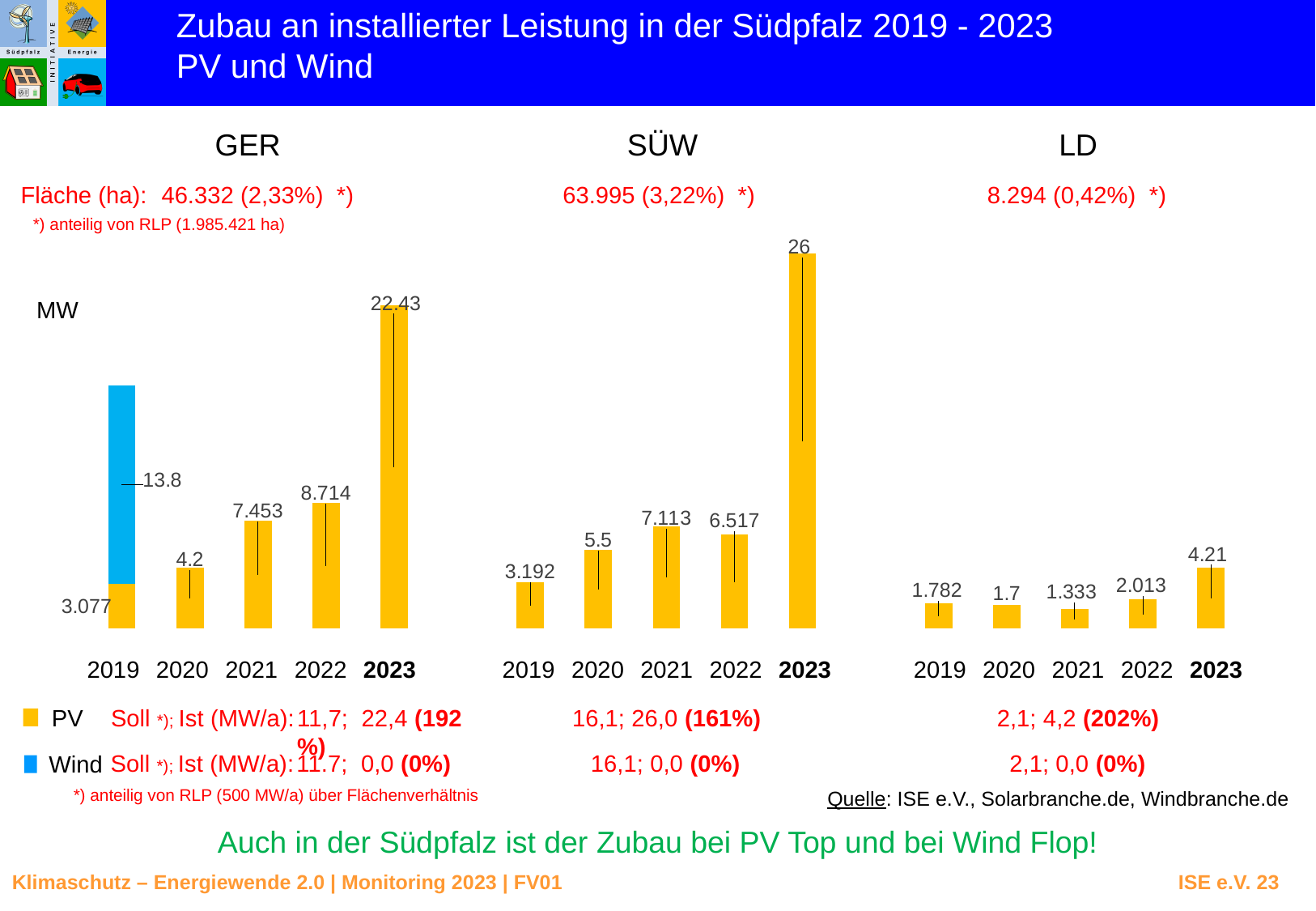
How many series does the legend list? 2 How many years are shown on the x axis of the LD chart? 5 In the LD chart, what is the PV value for 2019? 1.782 In the SÜW chart, what is the PV value for 2021? 7.113 In the GER chart, what is the difference between the PV values for 2023 and 2022? 13.716 In the SÜW chart, which is larger, the PV value for 2021 or for 2022? 2021 In the LD chart, which year has the lowest PV value? 2021 Which colour represents Wind in the legend? blue What kind of chart is the SÜW chart? bar chart In the GER chart, what is the PV value for 2022? 8.714 In the SÜW chart, which year has the highest PV value? 2023 In the GER chart, what is the Wind value for 2019? 13.8